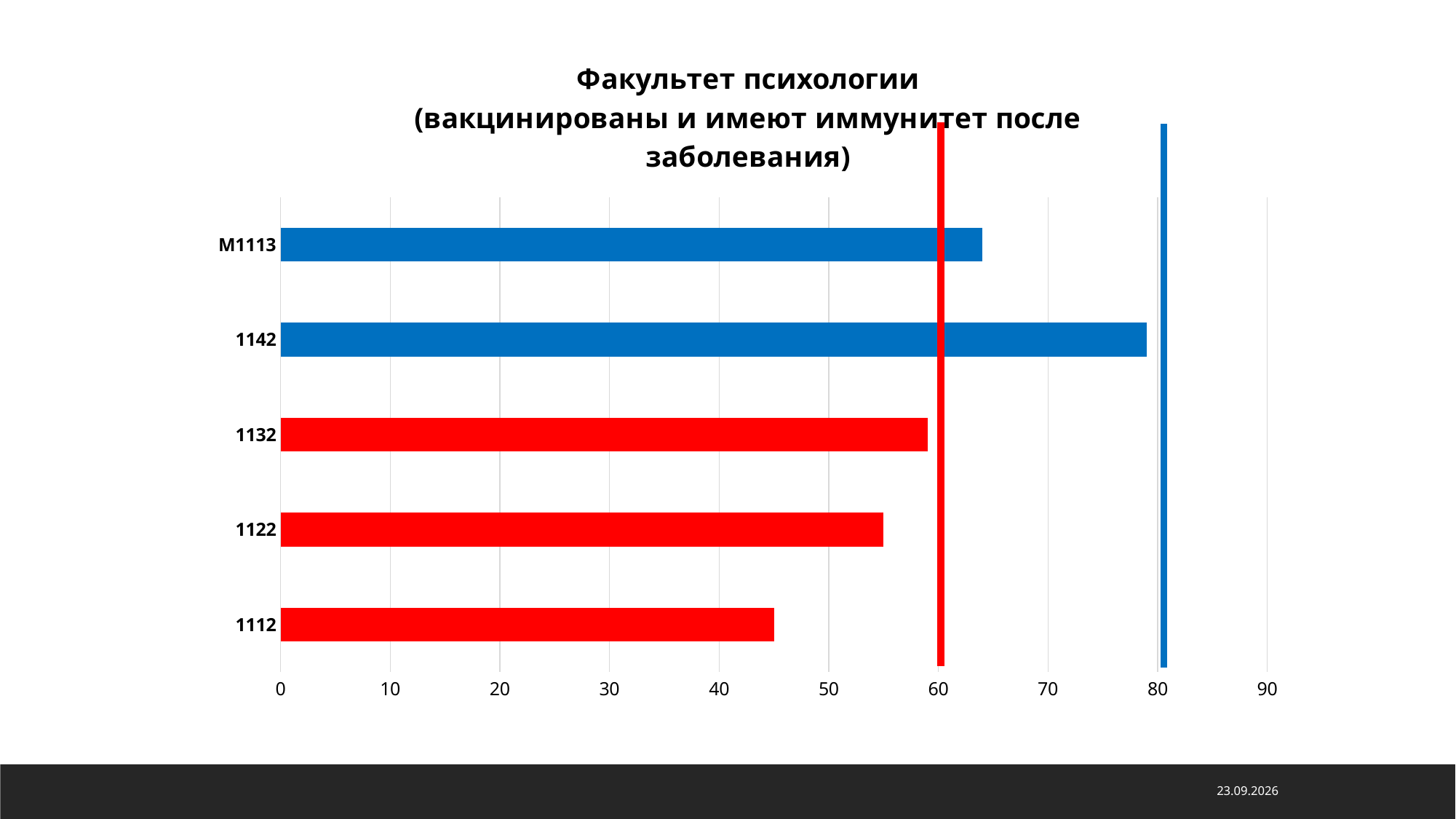
Is the value for 1112 greater or less than 50? less Which category has the highest value? 1142 Is the value for 1122 greater or less than 50? greater Which has the larger value, 1122 or 1112? 1122 Which category has the lowest value? 1112 Is the value for 1142 greater or less than 70? greater What kind of chart is shown on the slide? bar chart Which has the larger value, М1113 or 1132? М1113 How many categories are plotted in the chart? 5 How many bars in the chart are coloured blue? 2